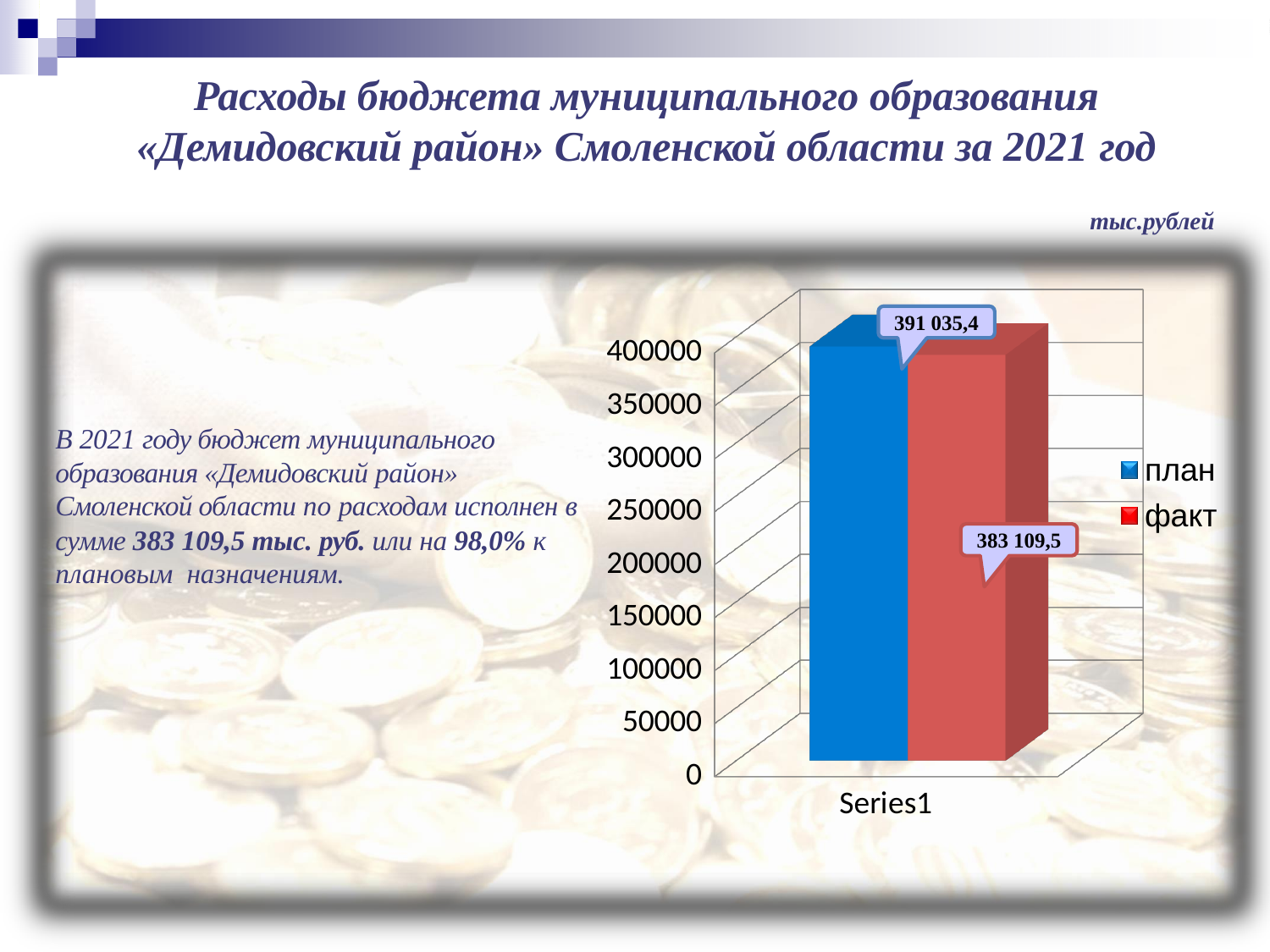
What is the difference between the план value and the факт value? 7 925,9 Is the value for факт greater or less than 350000? greater How many series does the legend list? 2 Is the value for план greater or less than 400000? less What kind of chart is shown on the slide? bar chart How many categories are shown on the x axis of the chart? 1 What is the value of the факт series on the chart? 383 109,5 What is the category label shown on the x axis of the chart? Series1 Which series has the higher value, план or факт? план What colour is the факт series in the chart? red What is the value of the план series on the chart? 391 035,4 Which series has the lowest value on the chart? факт